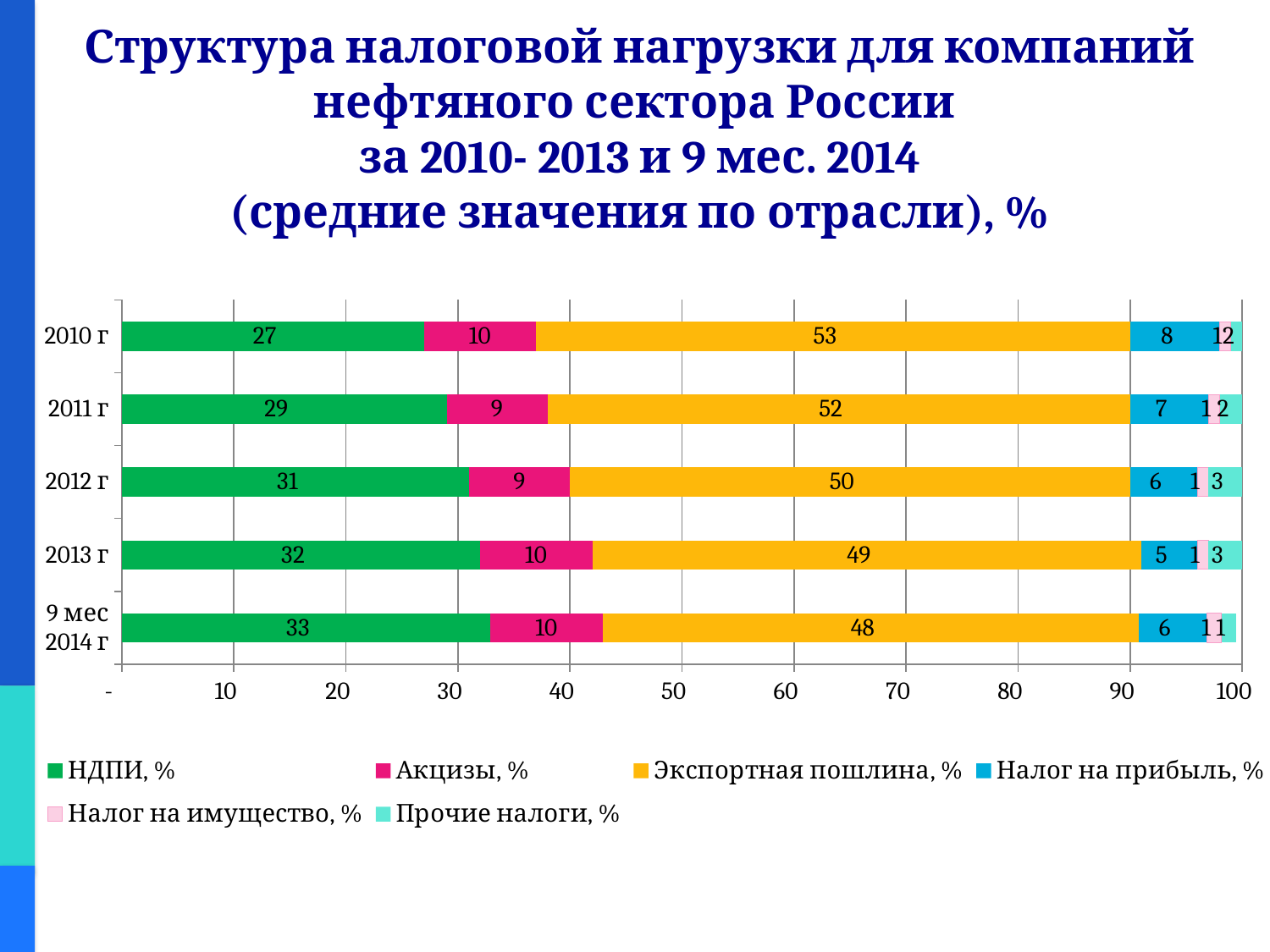
Which period has the highest value for НДПИ, %? 9 мес 2014 г What is the value of Налог на прибыль, % for 2011 г? 7 How many series does the legend list? 6 What is the difference between the Экспортная пошлина, % value for 2010 г and for 9 мес 2014 г? 5 What kind of chart is shown on the slide? Stacked bar chart Which period has the lowest value for Экспортная пошлина, %? 9 мес 2014 г What is the value of Экспортная пошлина, % for 2013 г? 49 How many periods (bars) are shown on the chart? 5 For 2012 г, which is larger: НДПИ, % or Акцизы, %? НДПИ, % What is the total of the stacked bar for 2012 г? 100 Does the value of НДПИ, % rise or fall from 2010 г to 9 мес 2014 г? Rises What is the value of НДПИ, % for 2010 г? 27